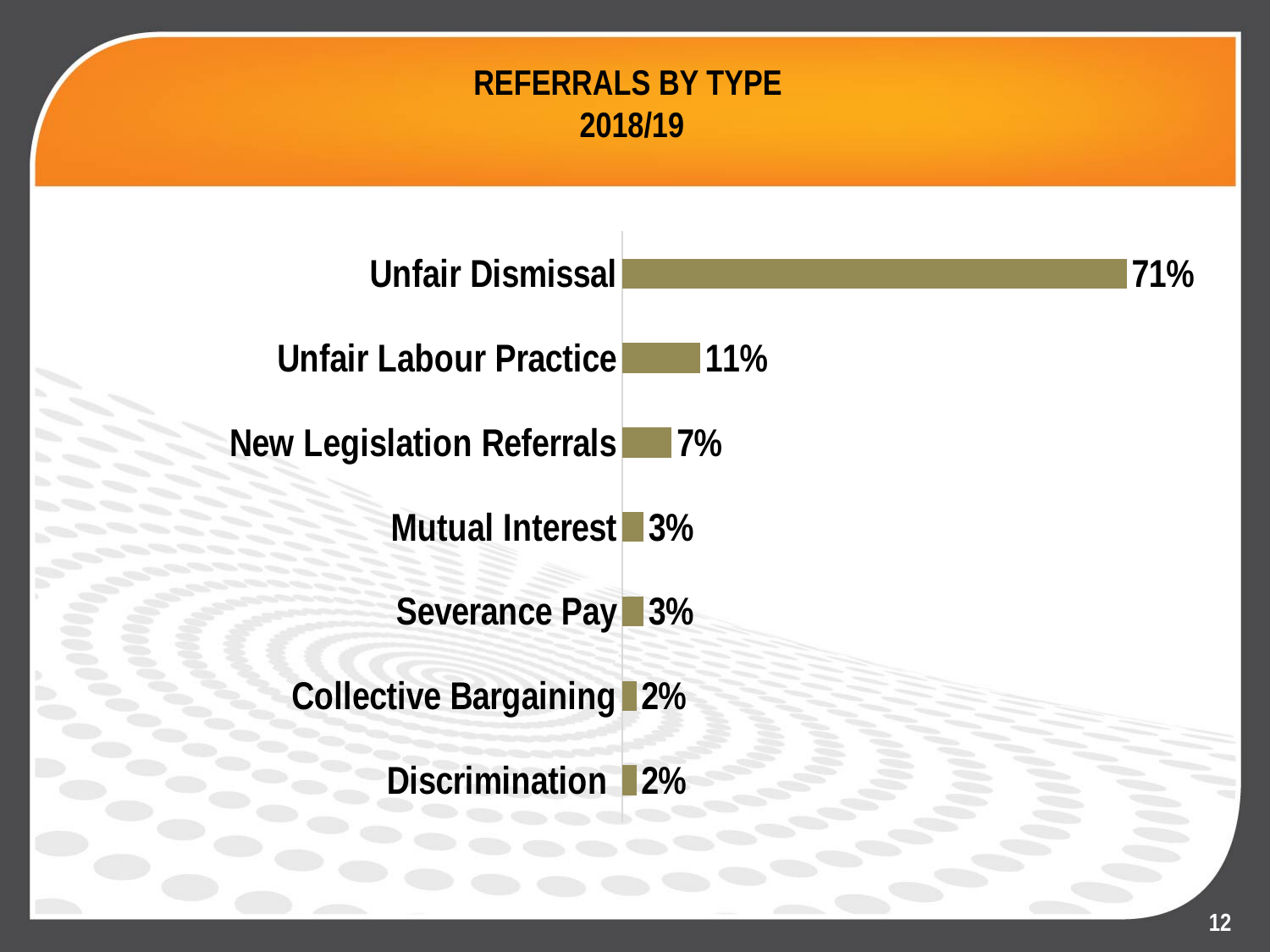
How many referral types are shown in the chart? 7 Which two referral types both have a value of 2%? Collective Bargaining and Discrimination What percentage of referrals were for Unfair Dismissal? 71% What percentage is shown for New Legislation Referrals? 7% What is the value for Severance Pay? 3% Which referral type has the highest percentage? Unfair Dismissal Which is larger, the value for New Legislation Referrals or the value for Mutual Interest? New Legislation Referrals What is the difference between the values for Unfair Labour Practice and New Legislation Referrals? 4 percentage points What kind of chart is shown on the slide? Bar chart What is the difference between the Unfair Dismissal and Unfair Labour Practice percentages? 60 percentage points What is the title of the slide? REFERRALS BY TYPE 2018/19 What is the value shown for Unfair Labour Practice? 11%